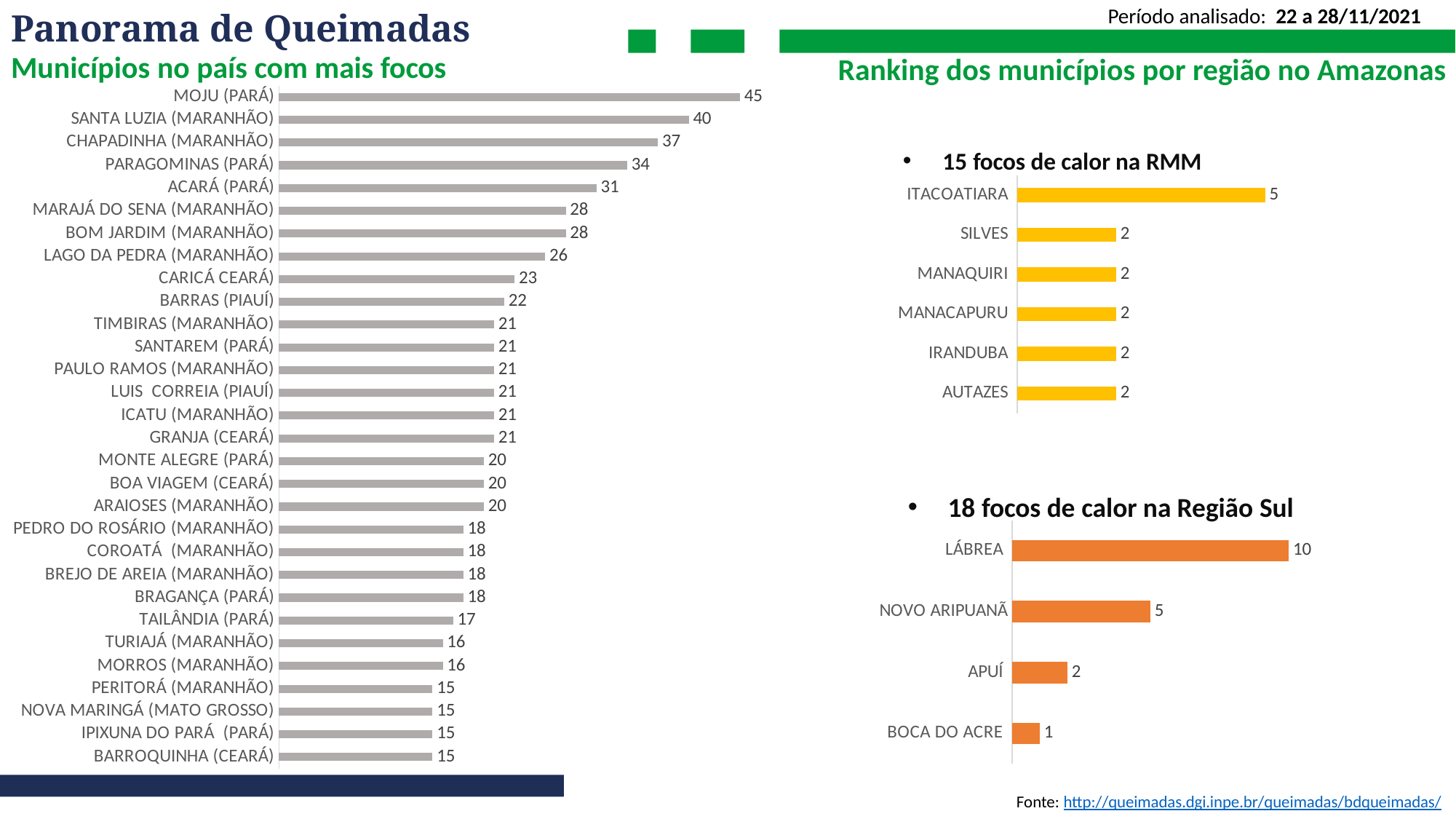
In the chart 'Municípios no país com mais focos', what is the value for MOJU (PARÁ)? 45 In the chart 'Municípios no país com mais focos', which is larger, ACARÁ (PARÁ) or LAGO DA PEDRA (MARANHÃO)? ACARÁ (PARÁ) In the chart '18 focos de calor na Região Sul', what is the difference between LÁBREA and NOVO ARIPUANÃ? 5 What colour are the bars in the chart '15 focos de calor na RMM'? Yellow In the chart '15 focos de calor na RMM', how many municipalities are shown? 6 How many municipalities are shown in the chart 'Municípios no país com mais focos'? 30 In the chart '15 focos de calor na RMM', what is the value for ITACOATIARA? 5 In the chart 'Municípios no país com mais focos', what is the difference between SANTA LUZIA (MARANHÃO) and PARAGOMINAS (PARÁ)? 6 In the chart 'Municípios no país com mais focos', what is the value for CHAPADINHA (MARANHÃO)? 37 In the chart '18 focos de calor na Região Sul', which municipality has the lowest value? BOCA DO ACRE What type of chart is '18 focos de calor na Região Sul'? Bar chart In the chart 'Municípios no país com mais focos', which municipality has the highest value? MOJU (PARÁ)